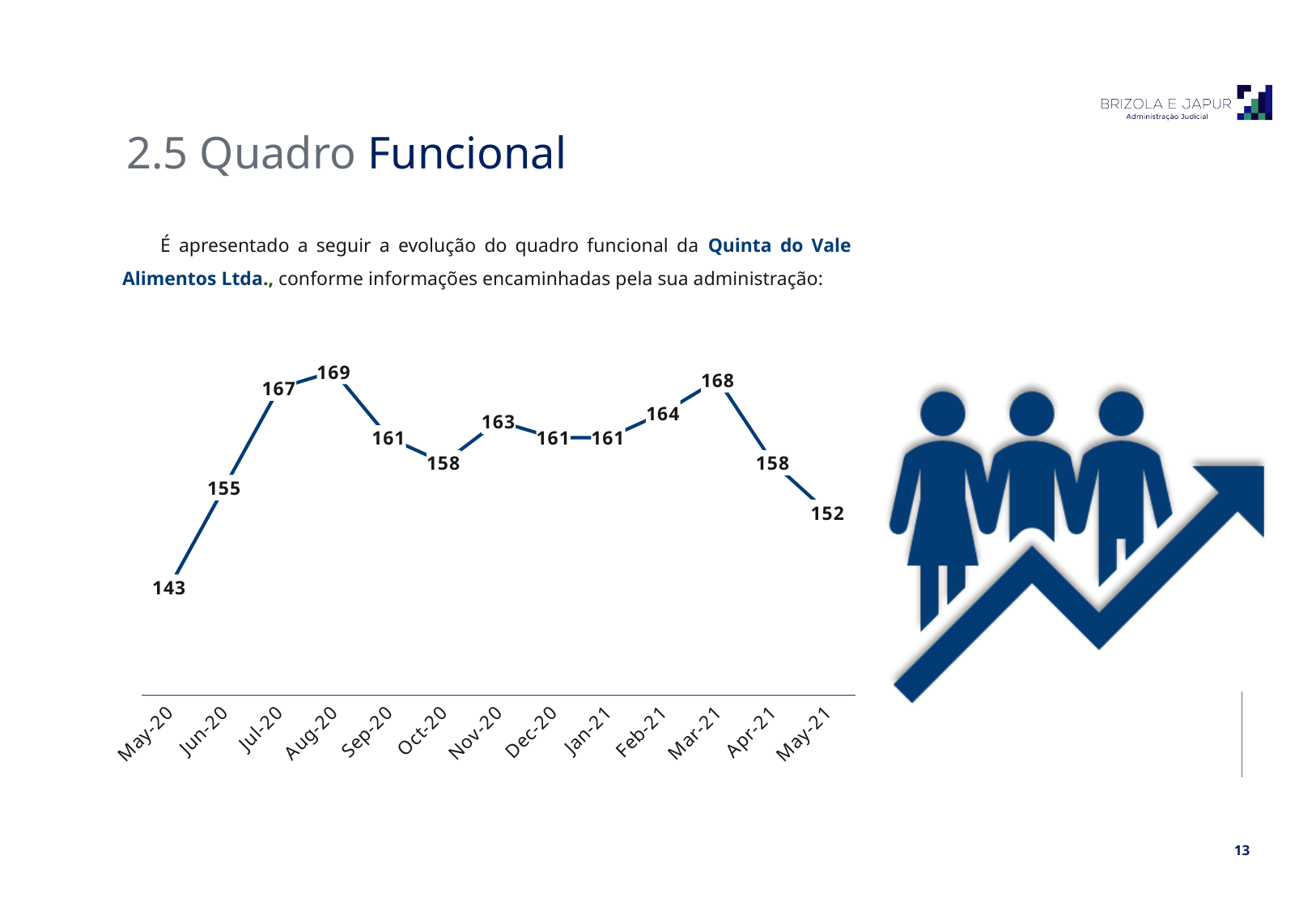
Which is larger, the value for Jul-20 or the value for Feb-21? Jul-20 How many data points are plotted on the chart? 13 What is the value for Mar-21? 168 Which month has the lowest value? May-20 Which month has the highest value? Aug-20 What kind of chart is shown on the slide? Line chart What is the difference between the values for Aug-20 and May-20? 26 What is the value for Aug-20? 169 Do the values rise or fall from Mar-21 to May-21? Fall What is the difference between the values for Mar-21 and May-21? 16 What is the value for May-21? 152 Do the values rise or fall from May-20 to Aug-20? Rise